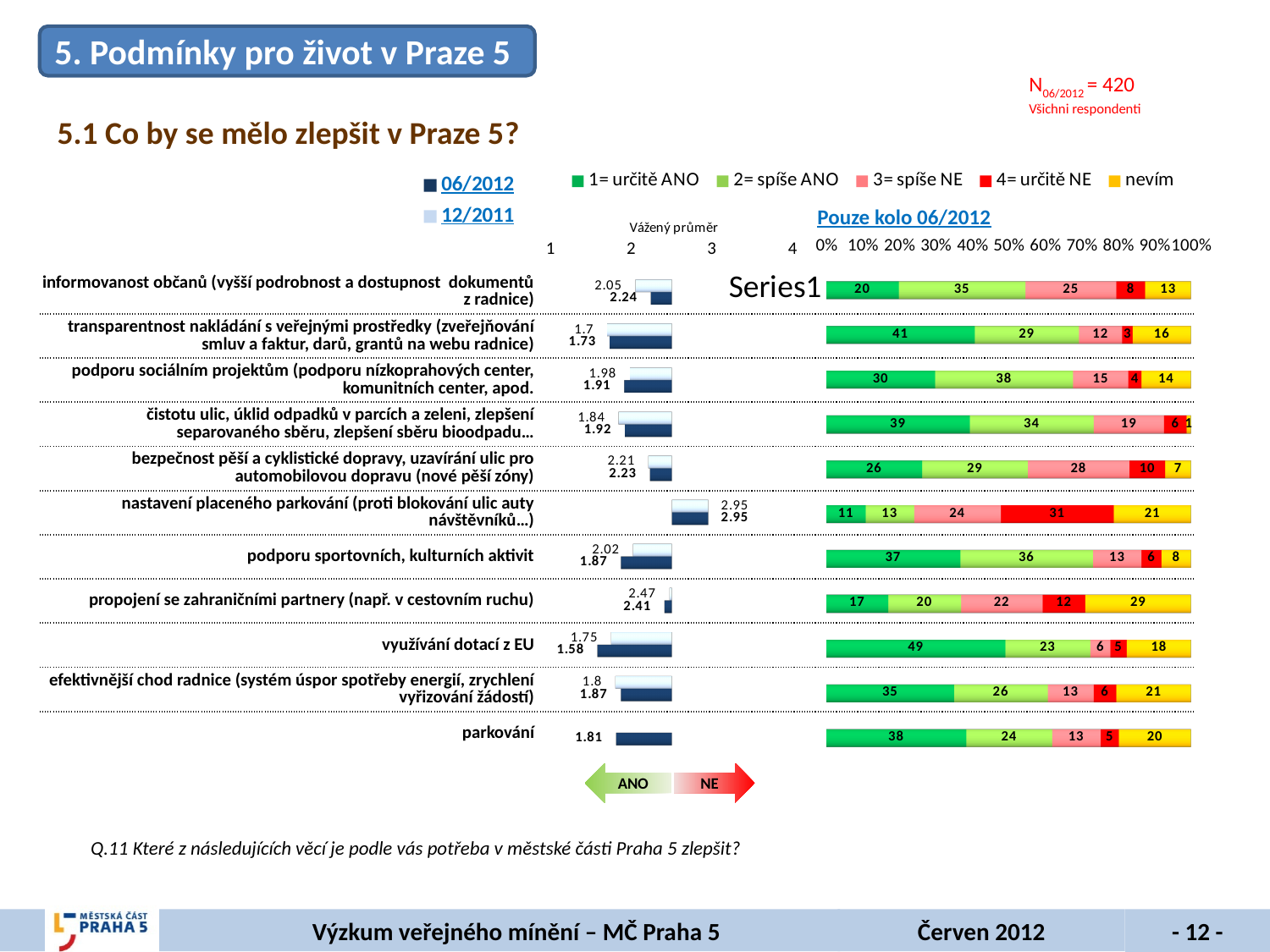
In the 'Pouze kolo 06/2012' stacked bar chart, what is the value of '1= určitě ANO' for 'využívání dotací z EU'? 49 How many series does the legend of the 'Pouze kolo 06/2012' stacked bar chart list? 5 In the 'Pouze kolo 06/2012' stacked bar chart, which category has the highest value for '1= určitě ANO'? využívání dotací z EU In the 'Pouze kolo 06/2012' stacked bar chart, which is larger: the '3= spíše NE' value for 'bezpečnost pěší a cyklistické dopravy' or for 'informovanost občanů'? bezpečnost pěší a cyklistické dopravy In the 'Pouze kolo 06/2012' stacked bar chart, what is the difference between the '2= spíše ANO' values for 'podporu sociálním projektům' and 'parkování'? 14 In the 'Pouze kolo 06/2012' stacked bar chart, what is the value of 'nevím' for 'propojení se zahraničními partnery (např. v cestovním ruchu)'? 29 How many categories are shown in the 'Pouze kolo 06/2012' stacked bar chart? 11 In the 'Vážený průměr' bar chart, which category has the highest weighted average? nastavení placeného parkování (proti blokování ulic auty návštěvníků…) What kind of chart is the 'Pouze kolo 06/2012' chart? stacked bar chart In the 'Pouze kolo 06/2012' stacked bar chart, which category has the lowest value for '1= určitě ANO'? nastavení placeného parkování (proti blokování ulic auty návštěvníků…) In the 'Vážený průměr' bar chart, what is the weighted average value shown for 'parkování'? 1.81 In the 'Pouze kolo 06/2012' stacked bar chart, what is the value of '4= určitě NE' for 'nastavení placeného parkování (proti blokování ulic auty návštěvníků…)'? 31